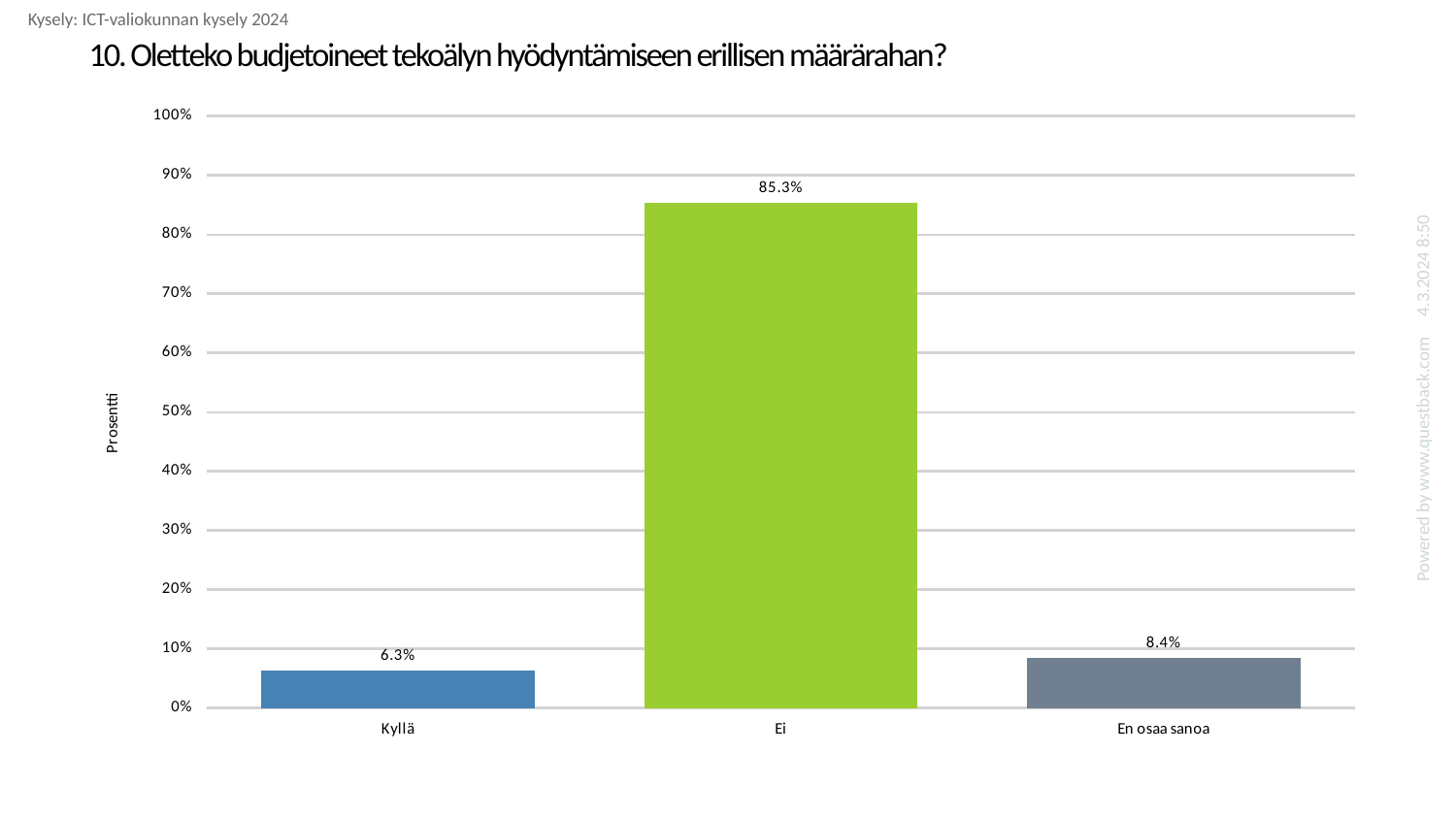
How many categories are shown on the x axis? 3 Which category has the highest value? Ei What is the label of the y axis? Prosentti Is the value for "Ei" greater or less than 80%? greater What kind of chart is shown on the slide? bar chart Which is larger, the value for "Kyllä" or the value for "En osaa sanoa"? En osaa sanoa What is the value for "Kyllä"? 6.3% What is the difference between the values for "Ei" and "En osaa sanoa"? 76.9% What is the value for "En osaa sanoa"? 8.4% What is the difference between the values for "En osaa sanoa" and "Kyllä"? 2.1% What is the value for "Ei"? 85.3% Which category has the lowest value? Kyllä